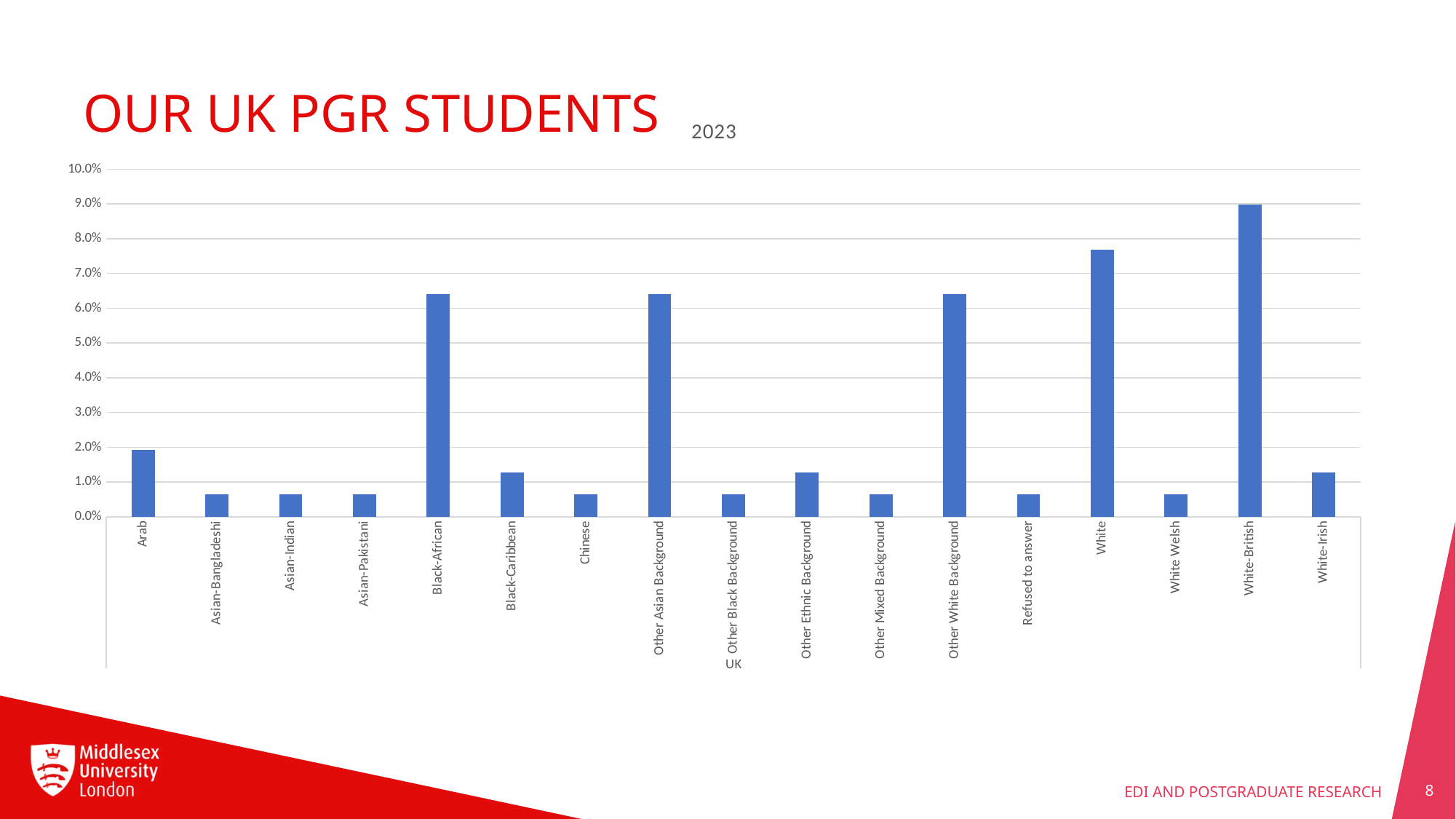
What is the title shown above the chart? 2023 Is the value for Black-Caribbean greater or less than 1.0%? greater What kind of chart is shown on the slide? bar chart Which is larger, the value for White-British or the value for White? White-British How many ethnicity categories are shown on the x axis of the chart? 17 Is the value for Chinese greater or less than 1.0%? less Is the value for White greater or less than 7.0%? greater Which is larger, the value for Black-African or the value for Arab? Black-African Which category has the highest value in the chart? White-British